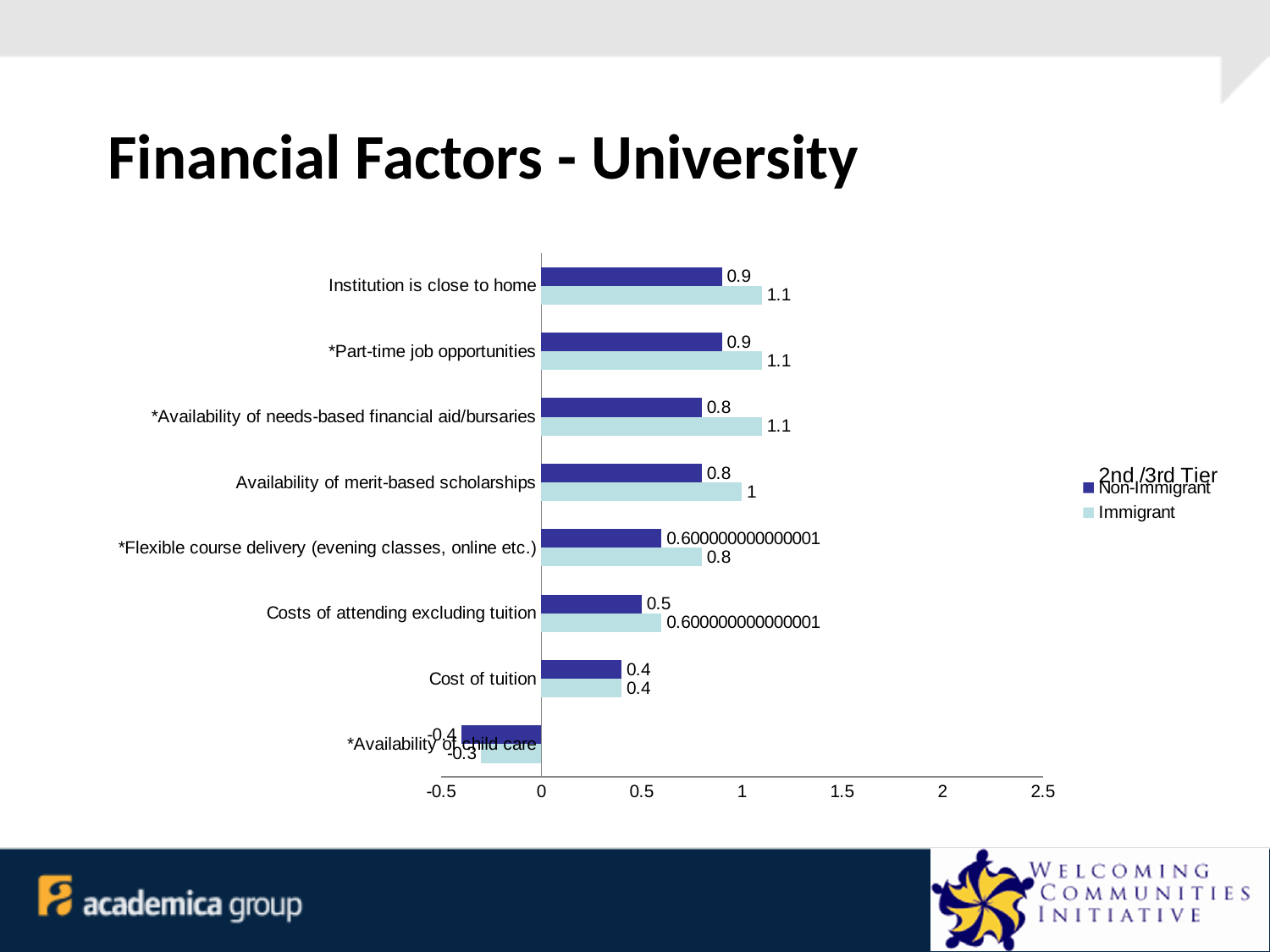
How many series does the legend list? 2 What is the title of the slide? Financial Factors - University What is the Non-Immigrant value for 'Cost of tuition'? 0.4 What is the Non-Immigrant value for '*Availability of needs-based financial aid/bursaries'? 0.8 How many categories are shown on the chart? 8 What kind of chart is shown on the slide? Bar chart Which is larger for '*Part-time job opportunities': the Non-Immigrant value or the Immigrant value? Immigrant What is the Immigrant value for 'Institution is close to home'? 1.1 What is the Immigrant value for 'Availability of merit-based scholarships'? 1 Which category has the lowest Immigrant value? *Availability of child care What is the difference between the Immigrant and Non-Immigrant values for '*Availability of needs-based financial aid/bursaries'? 0.3 What is the Non-Immigrant value for '*Availability of child care'? -0.4